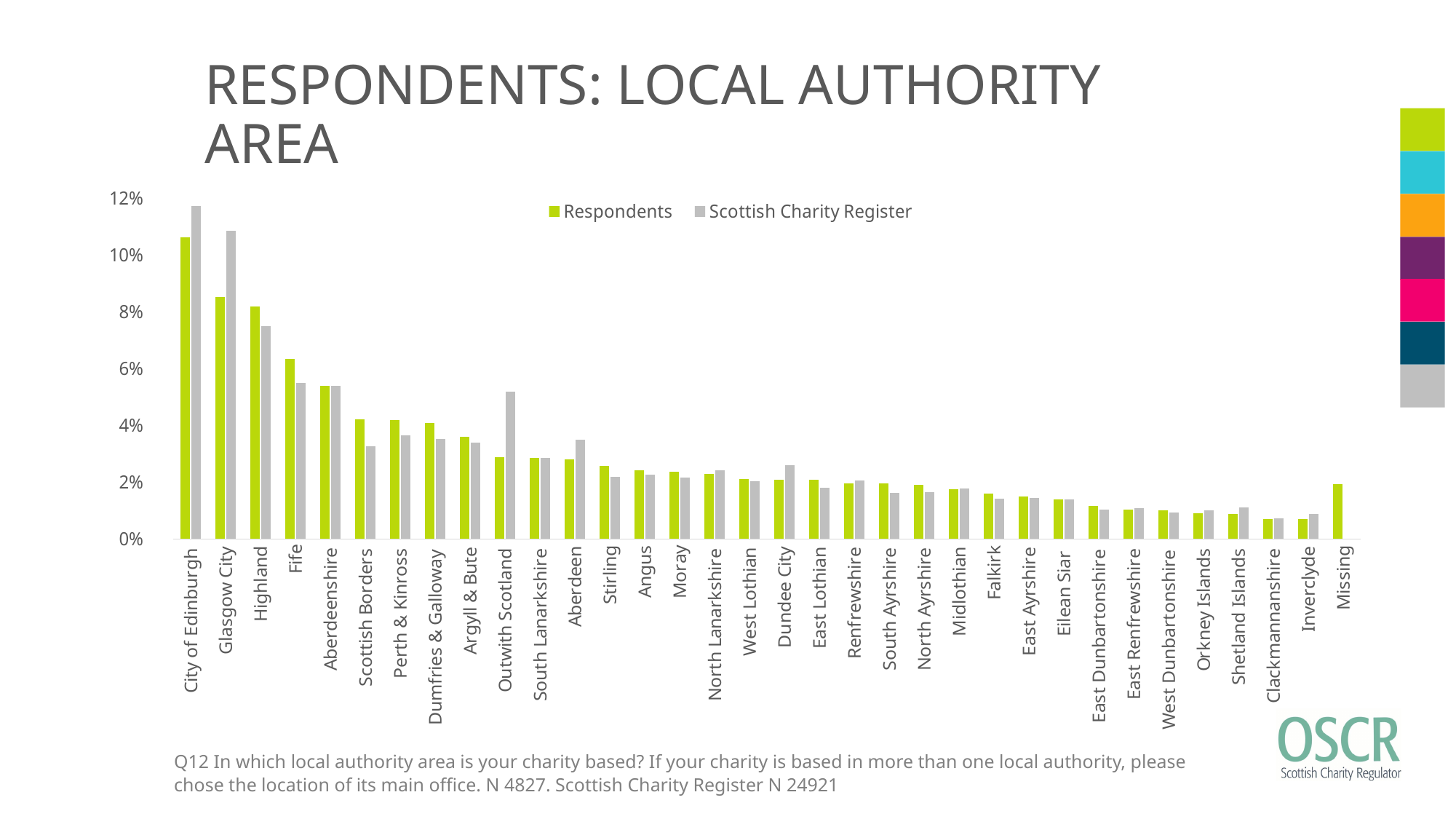
For Highland, which is larger: the Respondents value or the Scottish Charity Register value? Respondents Is the Scottish Charity Register value for Outwith Scotland greater or less than 4%? greater What kind of chart is shown on the slide? bar chart Is the Respondents value for City of Edinburgh greater or less than 10%? greater For Outwith Scotland, which is larger: the Respondents value or the Scottish Charity Register value? Scottish Charity Register Is the Scottish Charity Register value for Highland greater or less than 8%? less Do the Respondents values generally rise or fall from left to right across the x axis? fall Which local authority area has the highest Respondents value? City of Edinburgh How many series does the legend list? 2 Which local authority area has the highest Scottish Charity Register value? City of Edinburgh